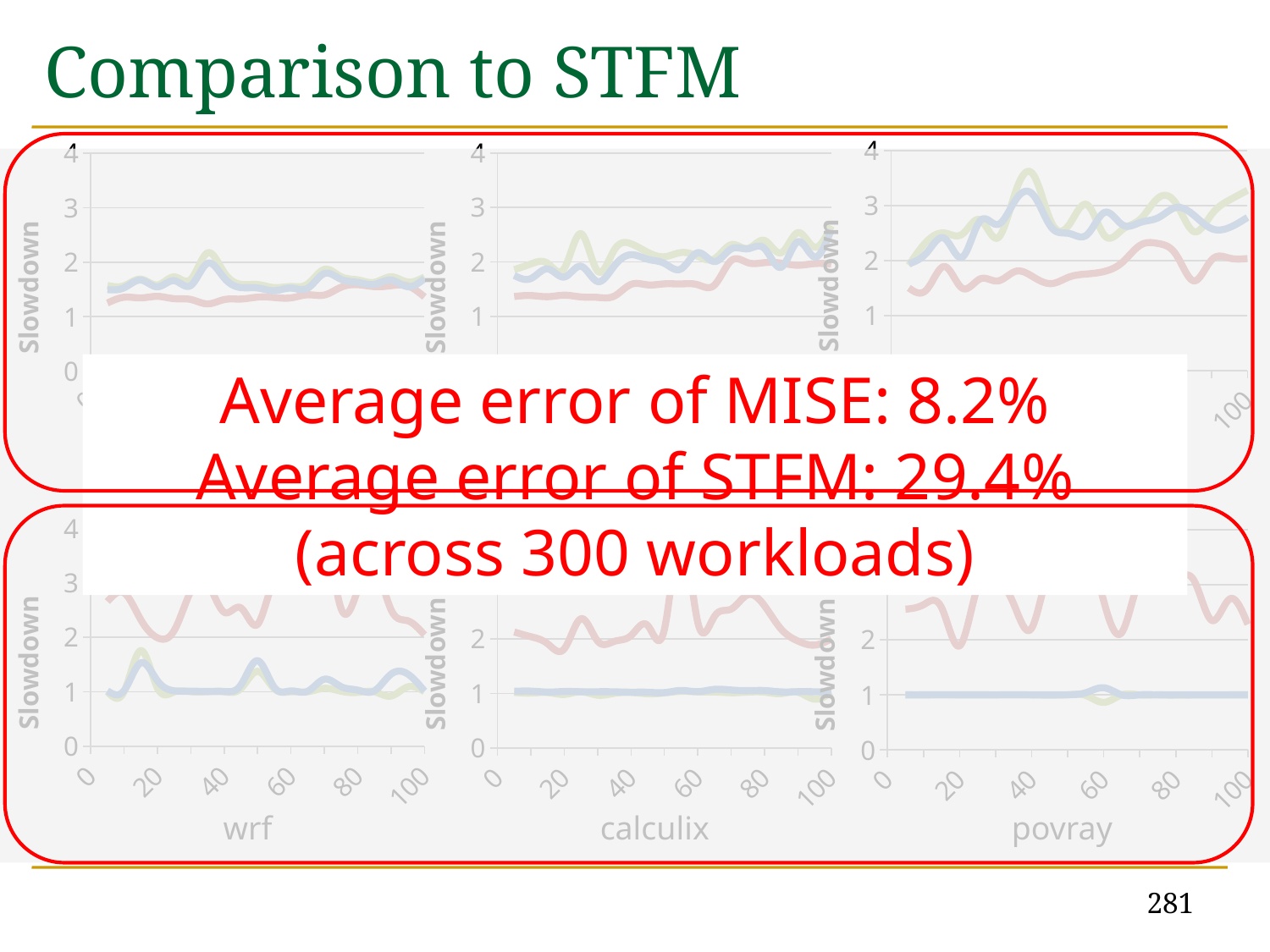
What is the x-axis label of the bottom-right chart panel? povray What is the x-axis label of the bottom-middle chart panel? calculix What is the y-axis label on the chart panels? Slowdown In the bottom-middle chart (calculix), is the blue line greater or less than 2 across the x axis? less What is the highest tick value shown on the y-axis of the chart panels? 4 What is the x-axis label of the bottom-left chart panel? wrf What is the highest tick value shown on the x-axis of the bottom chart panels? 100 In the top-right chart, is the peak of the green line greater or less than 3? greater In the top-left chart, is the blue line greater or less than 3 across the x axis? less In the bottom-right chart (povray), which line is higher, the red line or the blue line? red line What kind of chart is used in each of the six panels on the slide? line chart How many chart panels are shown on the slide? 6